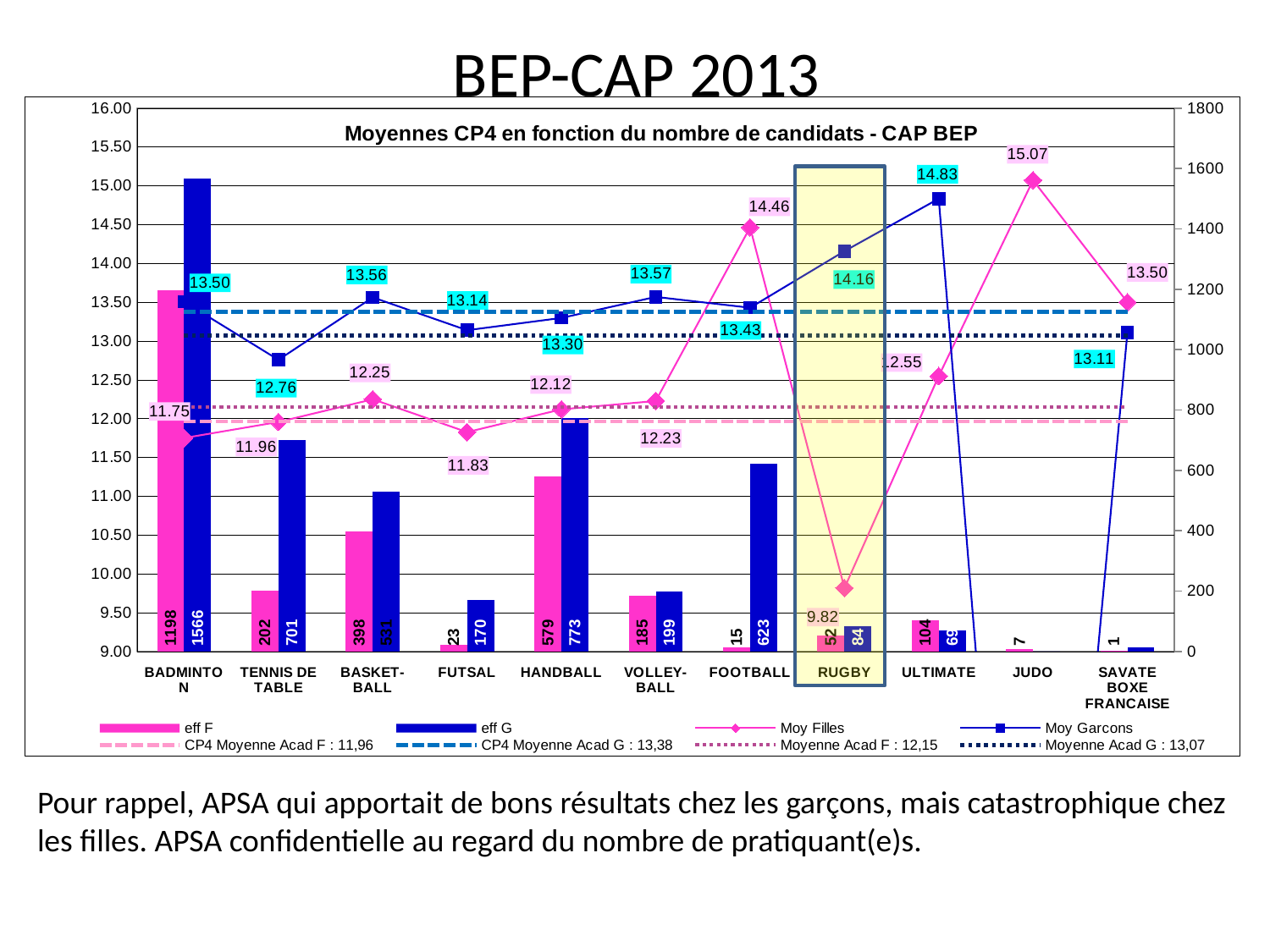
What is the difference between eff G and eff F for HANDBALL? 194 What is the eff F value for BADMINTON? 1198 How many entries does the legend list? 8 How many sport categories are shown on the x axis? 11 Which category has the lowest Moy Filles value? RUGBY What is the eff G value for FOOTBALL? 623 For FOOTBALL, which is larger: Moy Filles or Moy Garcons? Moy Filles What is the Moy Filles value for RUGBY? 9.82 What is the title of the chart? Moyennes CP4 en fonction du nombre de candidats - CAP BEP Which category has the highest eff G value? BADMINTON Which category has the highest Moy Filles value? JUDO What is the Moy Garcons value for ULTIMATE? 14.83